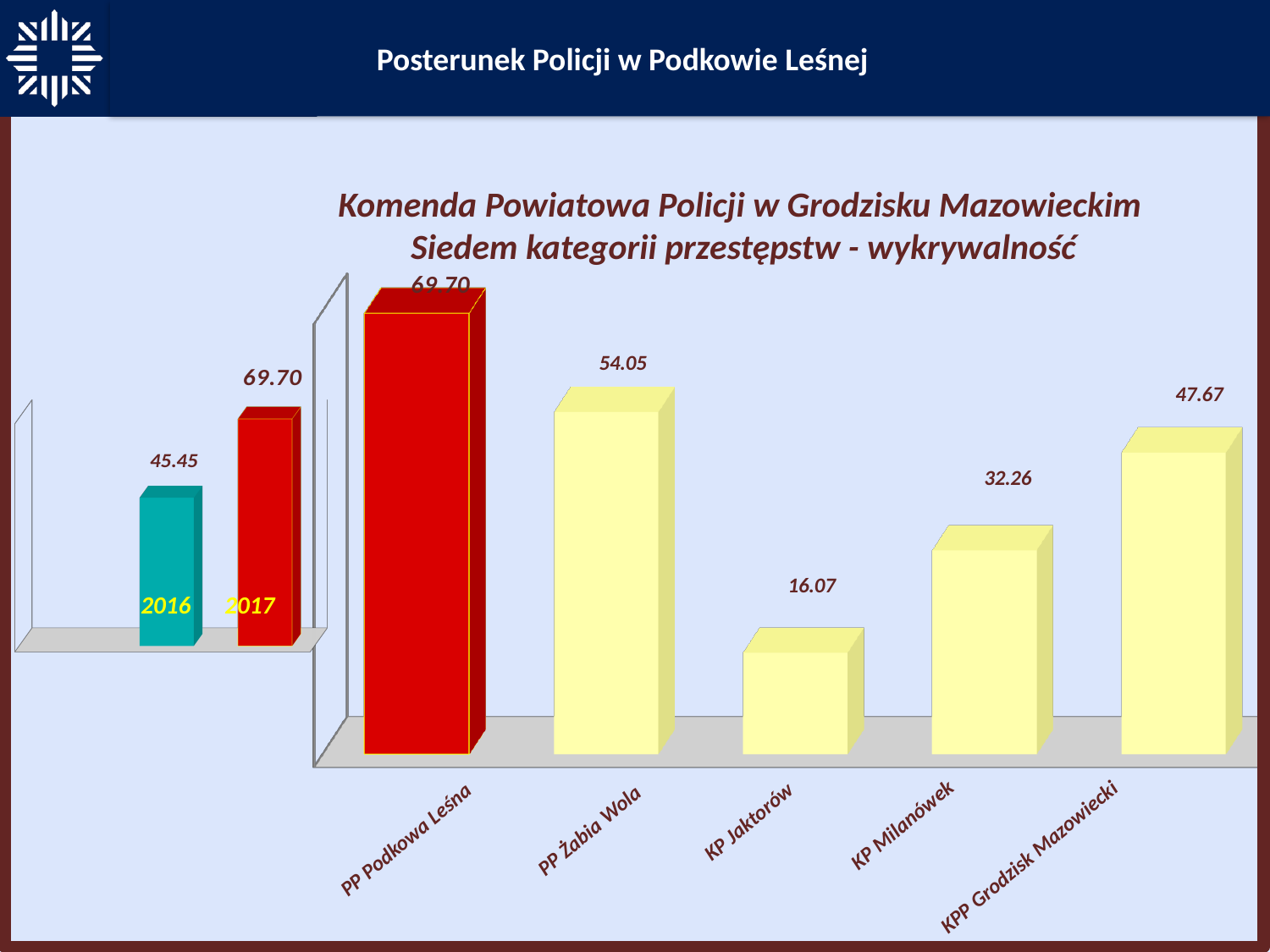
What kind of chart is the large chart titled 'Siedem kategorii przestępstw - wykrywalność'? bar chart In the small chart on the left, what is the value for 2016? 45.45 In the large chart titled 'Siedem kategorii przestępstw - wykrywalność', what is the difference between the values for PP Podkowa Leśna and PP Żabia Wola? 15.65 In the large chart titled 'Siedem kategorii przestępstw - wykrywalność', which category has the highest value? PP Podkowa Leśna In the large chart titled 'Siedem kategorii przestępstw - wykrywalność', what is the value for KP Jaktorów? 16.07 In the large chart titled 'Siedem kategorii przestępstw - wykrywalność', what is the value for PP Żabia Wola? 54.05 How many categories are shown in the large chart titled 'Siedem kategorii przestępstw - wykrywalność'? 5 In the small chart on the left, which year has the higher value, 2016 or 2017? 2017 In the small chart on the left, what is the difference between the 2017 and 2016 values? 24.25 In the large chart titled 'Siedem kategorii przestępstw - wykrywalność', which is larger: the value for KP Milanówek or KPP Grodzisk Mazowiecki? KPP Grodzisk Mazowiecki In the large chart titled 'Siedem kategorii przestępstw - wykrywalność', which category has the lowest value? KP Jaktorów In the large chart titled 'Siedem kategorii przestępstw - wykrywalność', what is the value for KPP Grodzisk Mazowiecki? 47.67